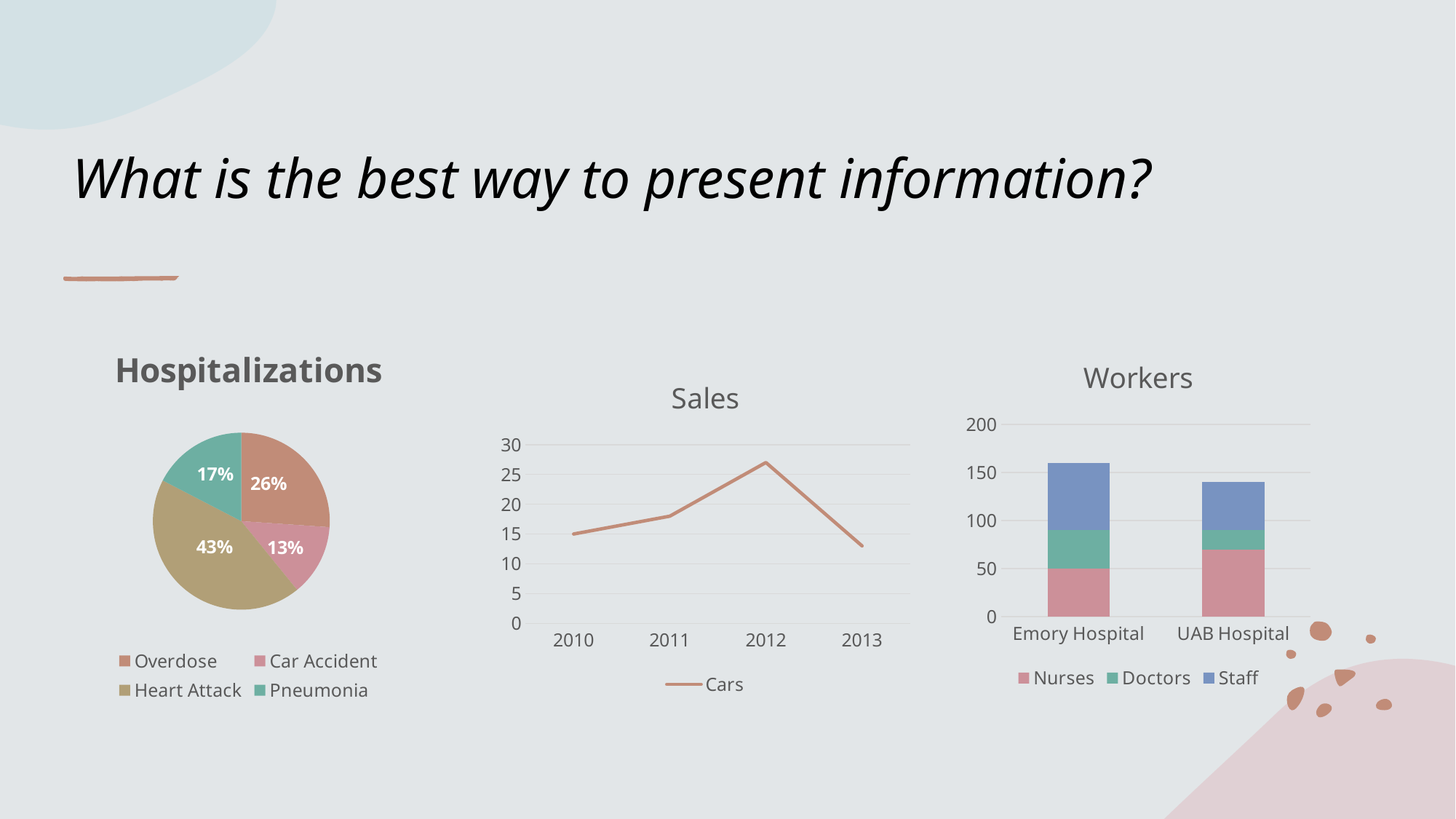
In the Sales chart, in which year is the value for Cars highest? 2012 In the Sales chart, does the value for Cars rise or fall from 2012 to 2013? Fall How many series does the legend of the Workers chart list? 3 In the Sales chart, is the value for Cars in 2012 greater or less than 25? greater In the Hospitalizations pie chart, what is the difference between the Overdose and Pneumonia shares? 9% What kind of chart is the Sales chart? Line chart In the Hospitalizations pie chart, what share is Car Accident? 13% In the Workers chart, is the total bar for Emory Hospital greater or less than 150? greater In the Hospitalizations pie chart, which category has the smallest share? Car Accident In the Hospitalizations pie chart, which category has the largest share? Heart Attack In the Hospitalizations pie chart, what share is Heart Attack? 43% How many categories does the Hospitalizations pie chart show? 4